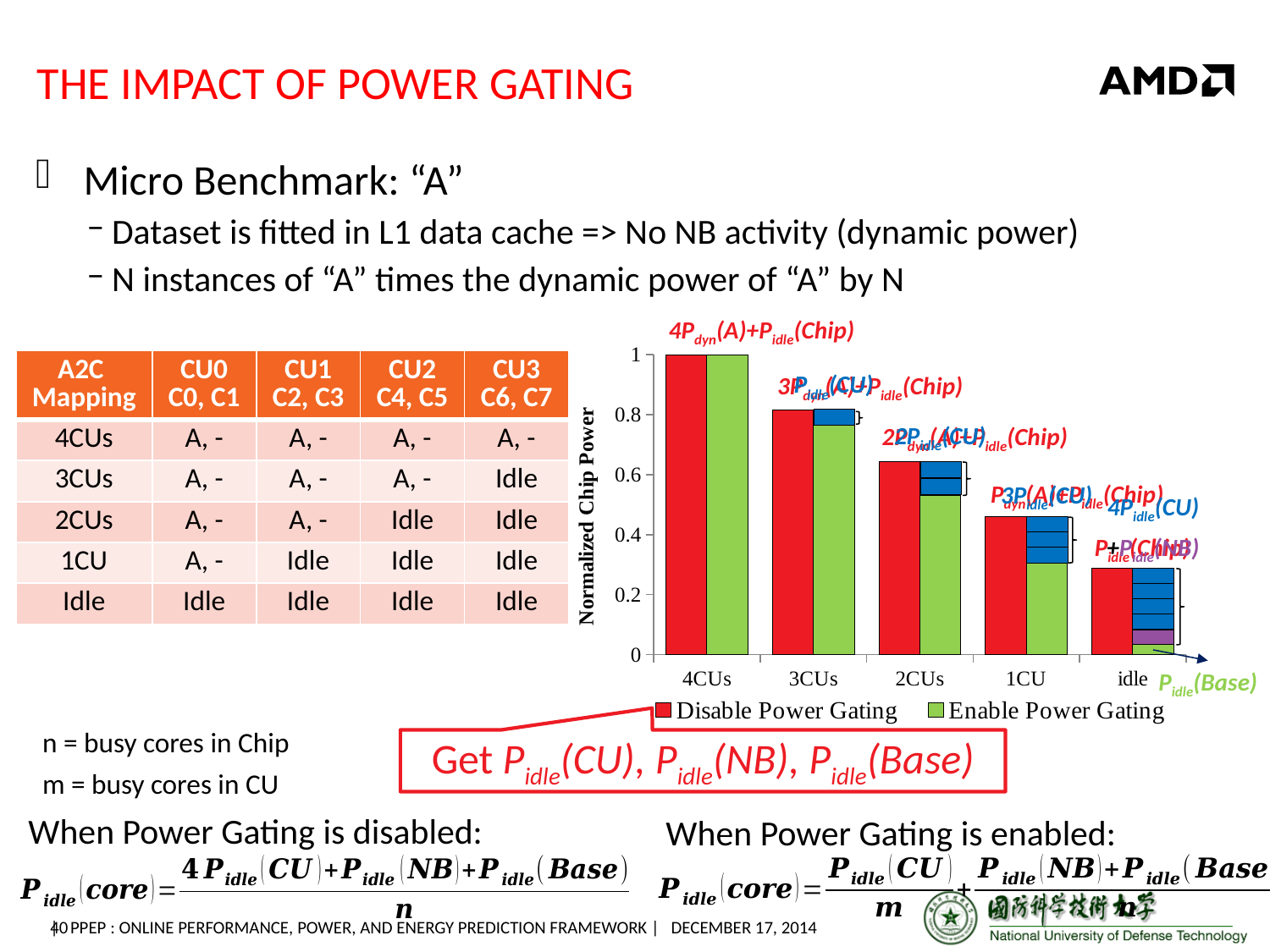
Which category has the lowest Enable Power Gating value? idle What is the Disable Power Gating value for 4CUs? 1 What kind of chart is shown on the slide? bar chart How many series does the chart legend list? 2 Which category has the highest Disable Power Gating value? 4CUs How many categories are shown on the x axis of the chart? 5 Is the Enable Power Gating value for idle greater or less than 0.2? less What is the title of the chart's y axis? Normalized Chip Power Is the Disable Power Gating value for 2CUs greater or less than 0.6? greater For 1CU, which is larger: the Disable Power Gating value or the Enable Power Gating value? Disable Power Gating Do the Disable Power Gating values rise or fall from 4CUs to idle along the x axis? fall What are the two series named in the chart legend? Disable Power Gating, Enable Power Gating